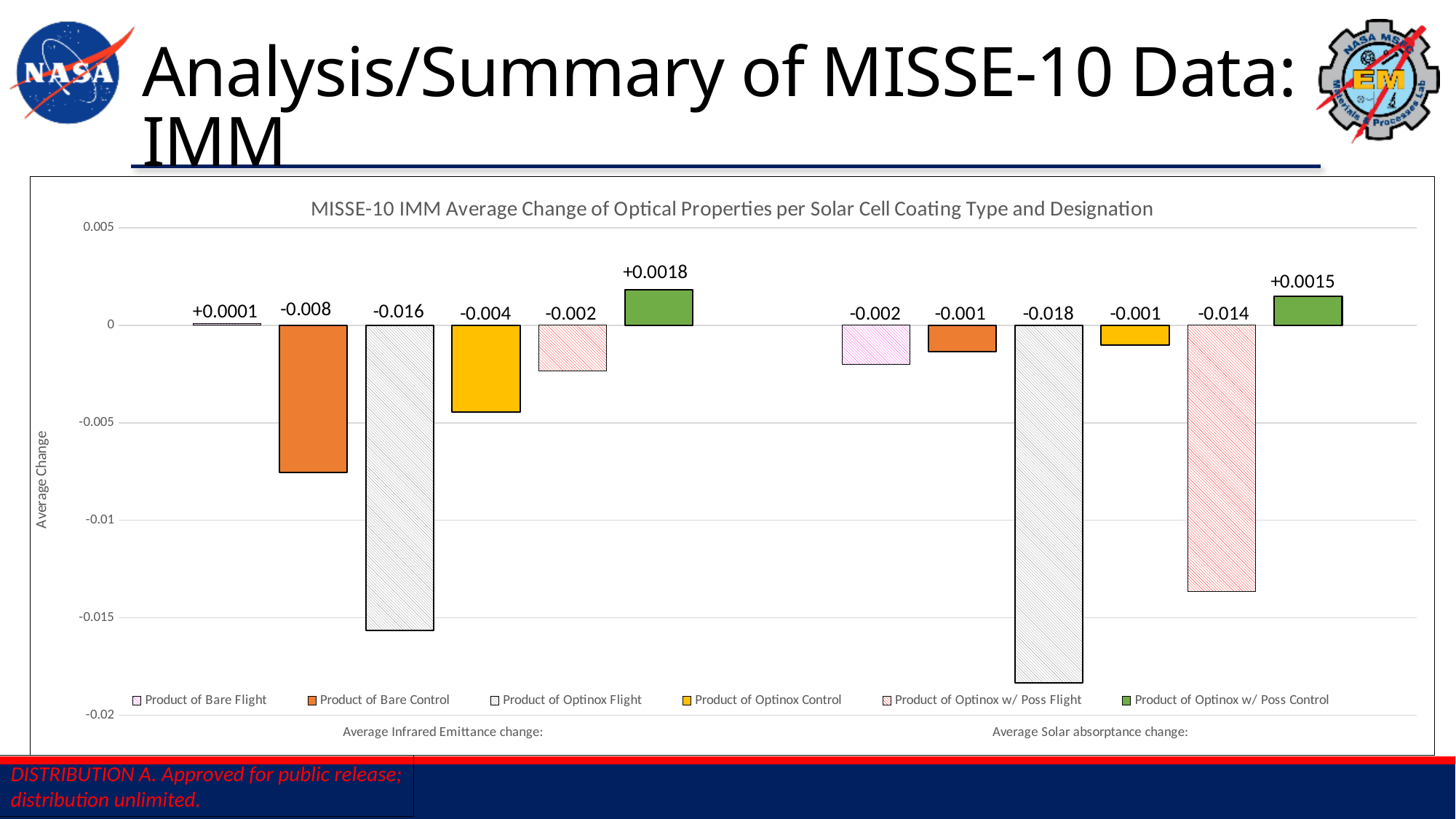
How many series does the legend list? 6 What kind of chart is shown on the slide? Bar chart What is the data label for Product of Optinox w/ Poss Control in the Average Solar absorptance change group? +0.0015 What is the title of the chart? MISSE-10 IMM Average Change of Optical Properties per Solar Cell Coating Type and Designation Which series has the lowest value in the Average Solar absorptance change group? Product of Optinox Flight Which series has the highest value in the Average Infrared Emittance change group? Product of Optinox w/ Poss Control Which is larger: the Average Infrared Emittance change for Product of Bare Control or for Product of Optinox Control? Product of Optinox Control What is the data label for Product of Bare Control in the Average Infrared Emittance change group? -0.008 Is the value for Product of Optinox Flight in the Average Solar absorptance change group greater or less than -0.015? less What is the data label for Product of Optinox w/ Poss Flight in the Average Solar absorptance change group? -0.014 How many category groups are shown on the x axis? 2 What is the data label for Product of Optinox Flight in the Average Infrared Emittance change group? -0.016